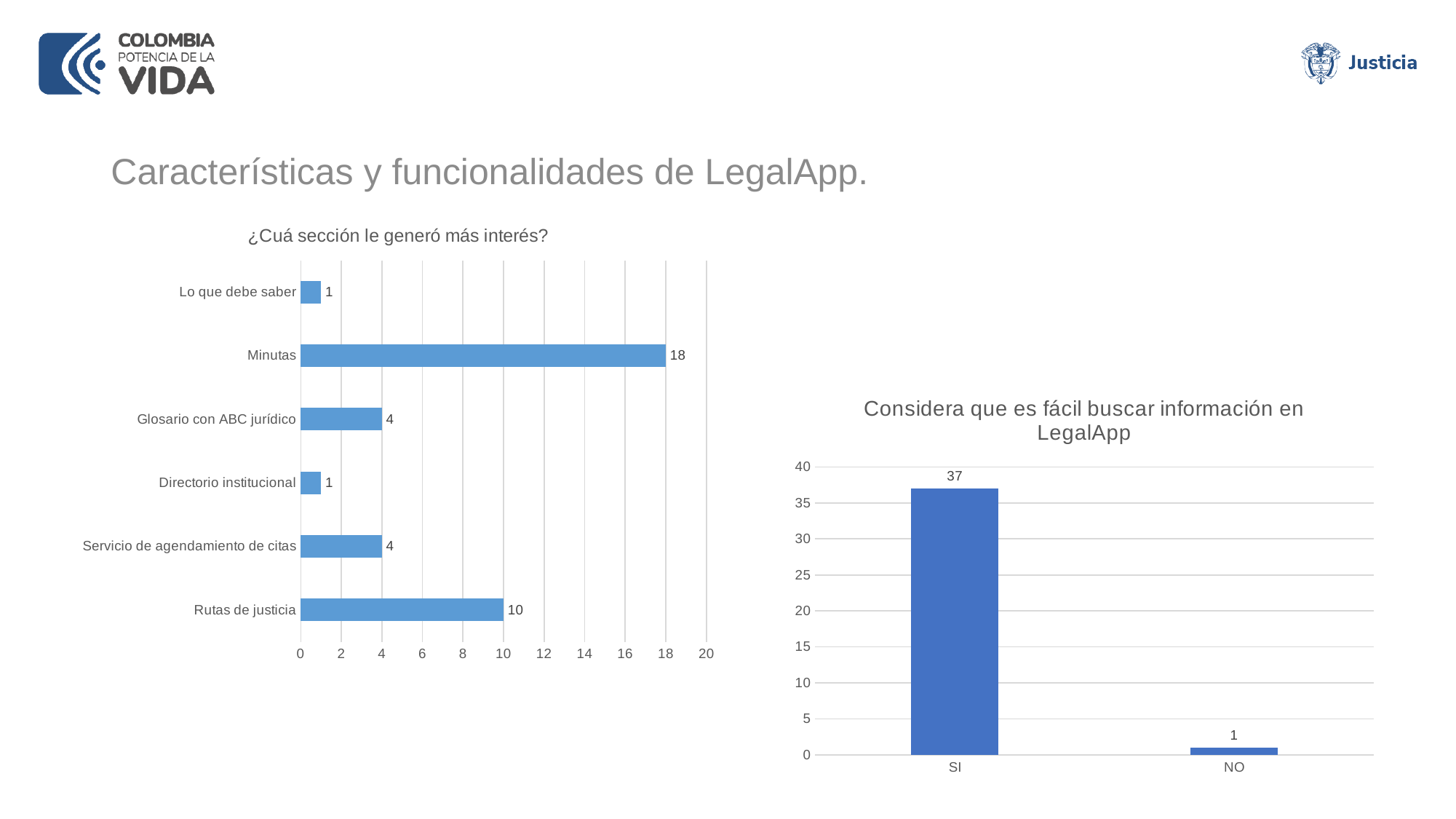
In the chart 'Considera que es fácil buscar información en LegalApp', what is the value for NO? 1 What kind of chart is '¿Cuá sección le generó más interés?'? Bar chart How many categories are shown in the chart '¿Cuá sección le generó más interés?'? 6 How many categories are shown in the chart 'Considera que es fácil buscar información en LegalApp'? 2 In the chart '¿Cuá sección le generó más interés?', what is the difference between Minutas and Rutas de justicia? 8 In the chart '¿Cuá sección le generó más interés?', what is the value for Minutas? 18 In the chart 'Considera que es fácil buscar información en LegalApp', what is the value for SI? 37 In the chart '¿Cuá sección le generó más interés?', what is the value for Rutas de justicia? 10 In the chart 'Considera que es fácil buscar información en LegalApp', what is the difference between SI and NO? 36 In the chart '¿Cuá sección le generó más interés?', which is larger: Glosario con ABC jurídico or Rutas de justicia? Rutas de justicia In the chart '¿Cuá sección le generó más interés?', which category has the highest value? Minutas In the chart 'Considera que es fácil buscar información en LegalApp', which category has the lowest value? NO